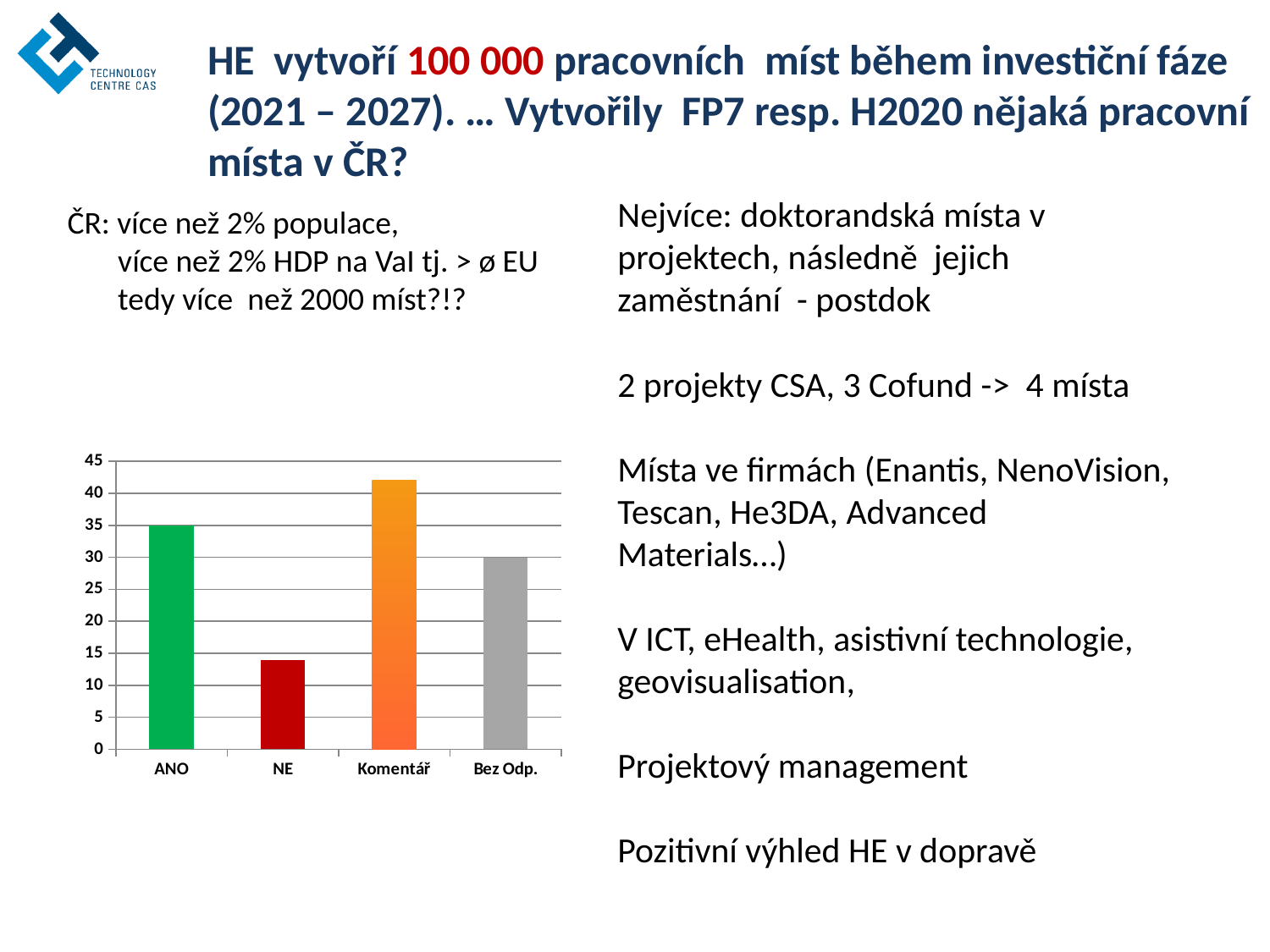
What kind of chart is shown on the slide? bar chart What is the difference between the values for ANO and Bez Odp.? 5 What colour is the bar for ANO in the chart? green What is the value for Bez Odp. in the chart? 30 Which is larger, the value for ANO or the value for Bez Odp.? ANO Is the value for Komentář greater or less than 40? greater Is the value for NE greater or less than 15? less Which is larger, the value for NE or the value for Bez Odp.? Bez Odp. Which category has the highest bar in the chart? Komentář Which category has the lowest bar in the chart? NE How many categories are shown on the x axis of the chart? 4 What is the value for ANO in the chart? 35